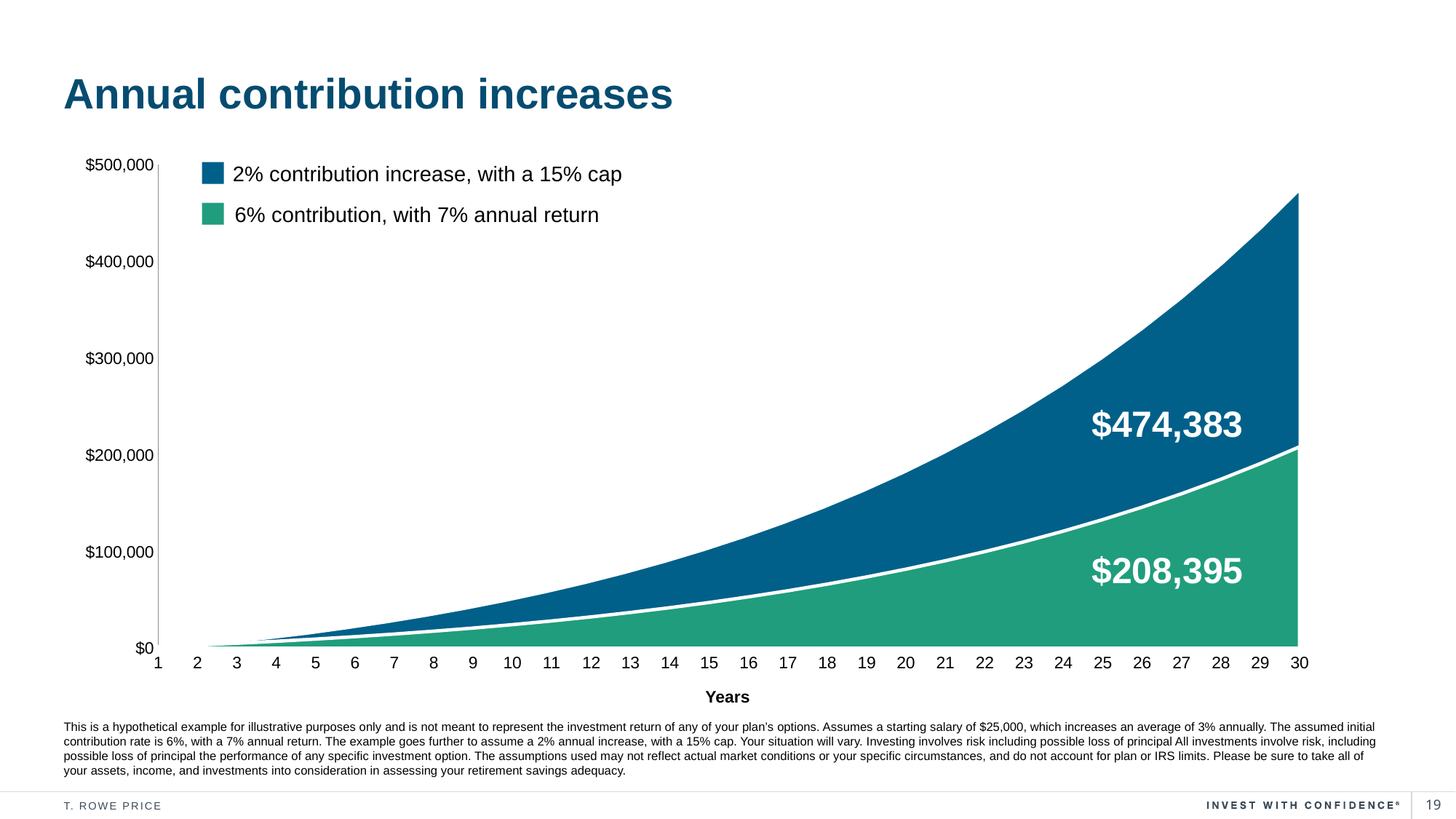
Which series has the larger value at year 30? 2% contribution increase, with a 15% cap Is the value for the '2% contribution increase, with a 15% cap' series at year 10 greater or less than $100,000? less What is the title of the x axis? Years What kind of chart is shown on the slide? Area chart What is the value shown for the '2% contribution increase, with a 15% cap' series at year 30? $474,383 Is the value for the '6% contribution, with 7% annual return' series at year 20 greater or less than $100,000? less How many series does the legend list? 2 How many years are shown along the x axis? 30 Which colour represents the '6% contribution, with 7% annual return' series? Green What is the value shown for the '6% contribution, with 7% annual return' series at year 30? $208,395 What is the difference between the two labelled values, $474,383 and $208,395? $265,988 Do the values rise or fall as the years increase along the x axis? Rise